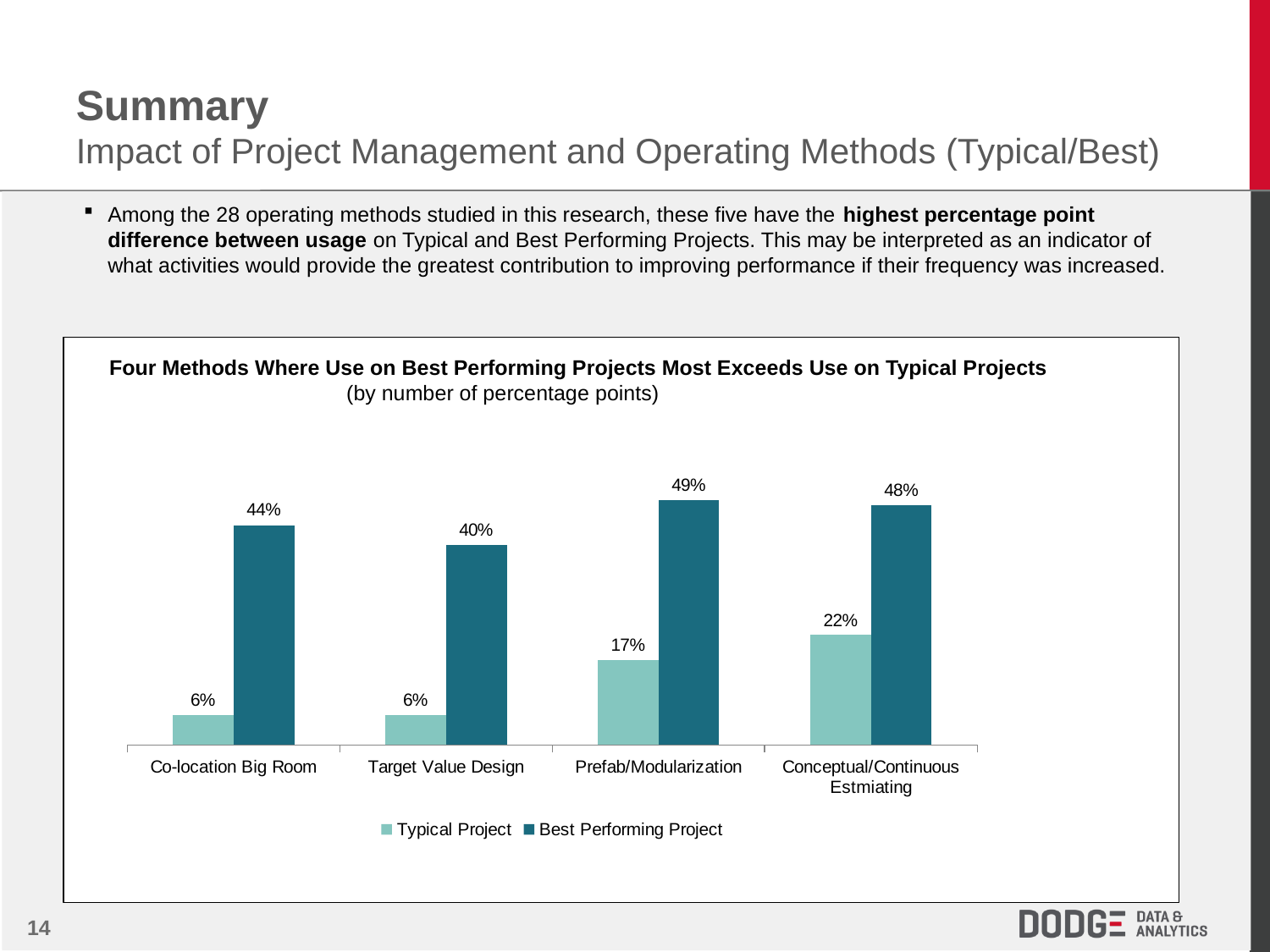
What is the Typical Project value for Prefab/Modularization? 17% Which series is shown in the darker teal colour in the chart? Best Performing Project Which category has the lowest Best Performing Project value? Target Value Design Which is larger: the Typical Project value for Conceptual/Continuous Estmiating or the Typical Project value for Prefab/Modularization? Conceptual/Continuous Estmiating How many series does the chart's legend list? 2 What is the Best Performing Project value for Co-location Big Room? 44% What kind of chart is shown on the slide? Bar chart What is the Typical Project value for Conceptual/Continuous Estmiating? 22% Which category has the highest Best Performing Project value? Prefab/Modularization What is the difference between the Best Performing Project and Typical Project values for Target Value Design? 34 percentage points What is the difference between the Best Performing Project and Typical Project values for Prefab/Modularization? 32 percentage points How many categories are shown on the x axis of the chart? 4